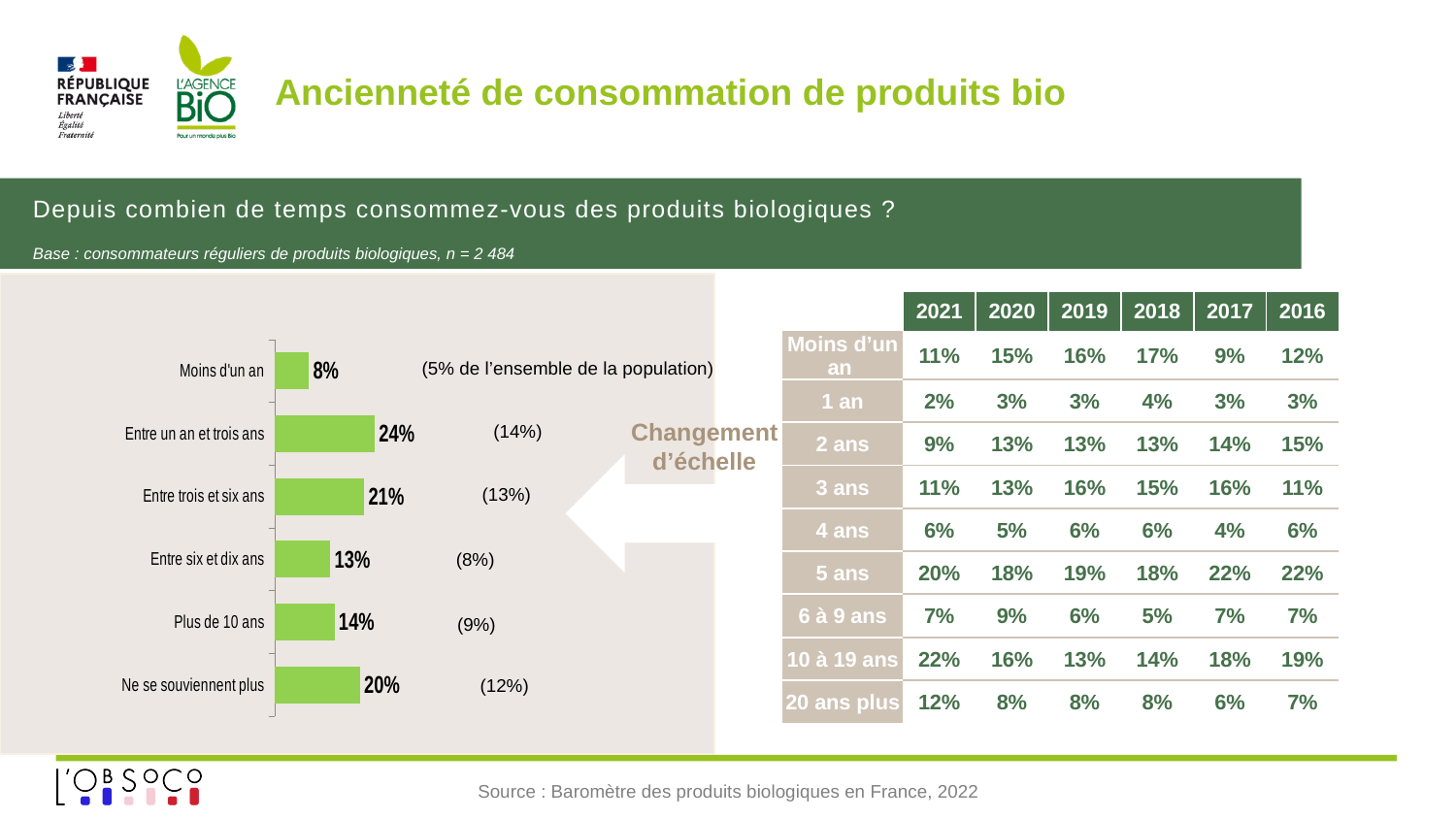
What value does the bar chart show for "Ne se souviennent plus"? 20% What value does the bar chart show for "Plus de 10 ans"? 14% Which category has the highest value in the bar chart? Entre un an et trois ans What value does the bar chart show for "Moins d'un an"? 8% In the bar chart, which is larger: the value for "Entre trois et six ans" or the value for "Entre six et dix ans"? Entre trois et six ans What value does the bar chart show for "Entre un an et trois ans"? 24% How many categories does the bar chart show? 6 What colour are the bars in the bar chart? Green Which category has the lowest value in the bar chart? Moins d'un an What kind of chart is shown on the left of the slide? Bar chart What is the difference between the values for "Ne se souviennent plus" and "Moins d'un an" in the bar chart? 12% What is the difference between the values for "Entre un an et trois ans" and "Entre trois et six ans" in the bar chart? 3%